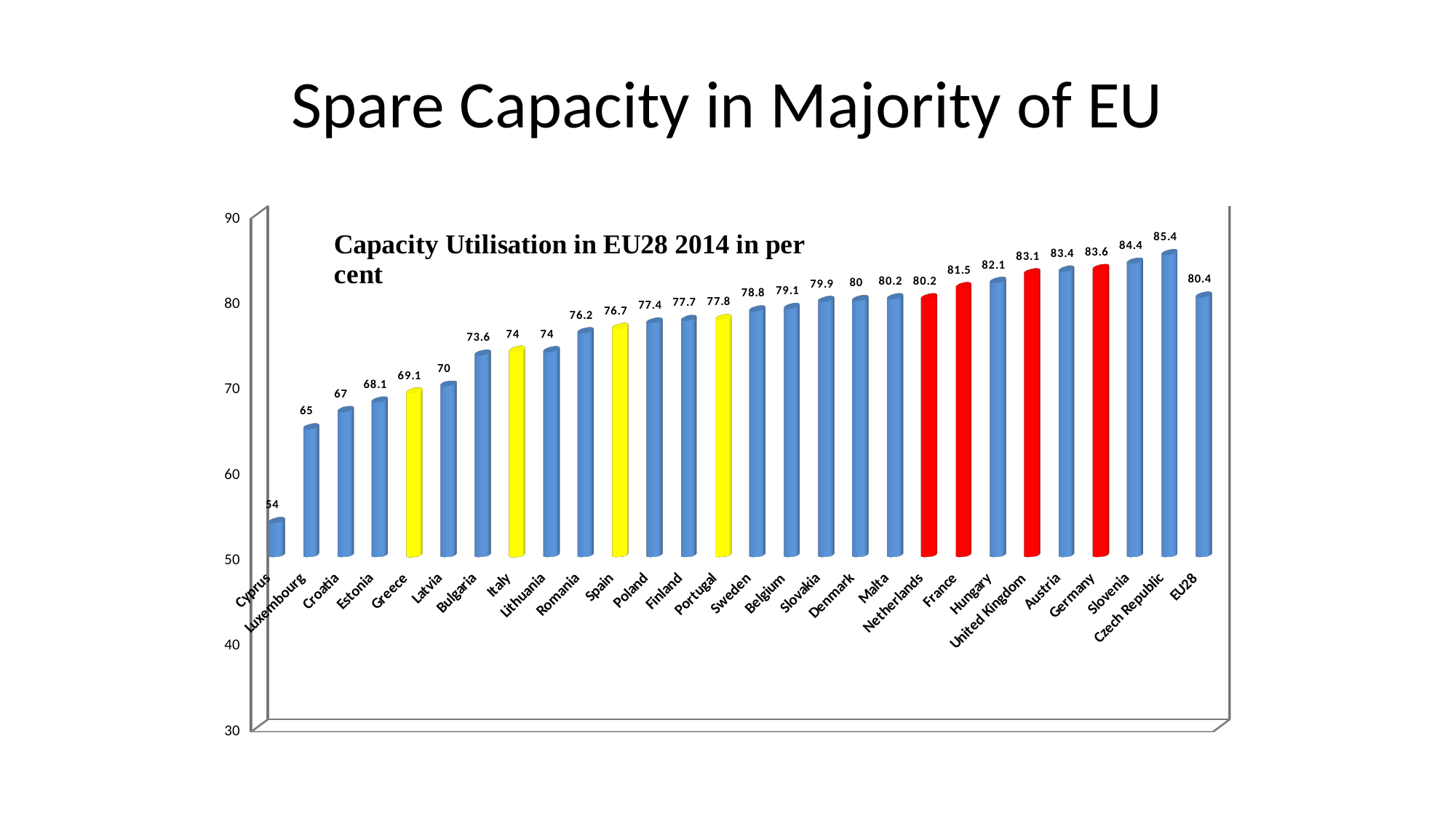
Which country has the lowest capacity utilisation in the chart? Cyprus What is the capacity utilisation value shown for Cyprus? 54 What is the title of the chart? Capacity Utilisation in EU28 2014 in per cent What is the difference between the values for Czech Republic and Cyprus? 31.4 What is the value shown for the EU28 bar? 80.4 What is the difference between the values for Germany and France? 2.1 What is the value shown for Germany? 83.6 Is the value for Luxembourg greater or less than 70? less How many bars are plotted in the chart? 28 What kind of chart is shown on the slide? Bar chart Which country has the highest capacity utilisation in the chart? Czech Republic Which has a higher value, Spain or Poland? Poland